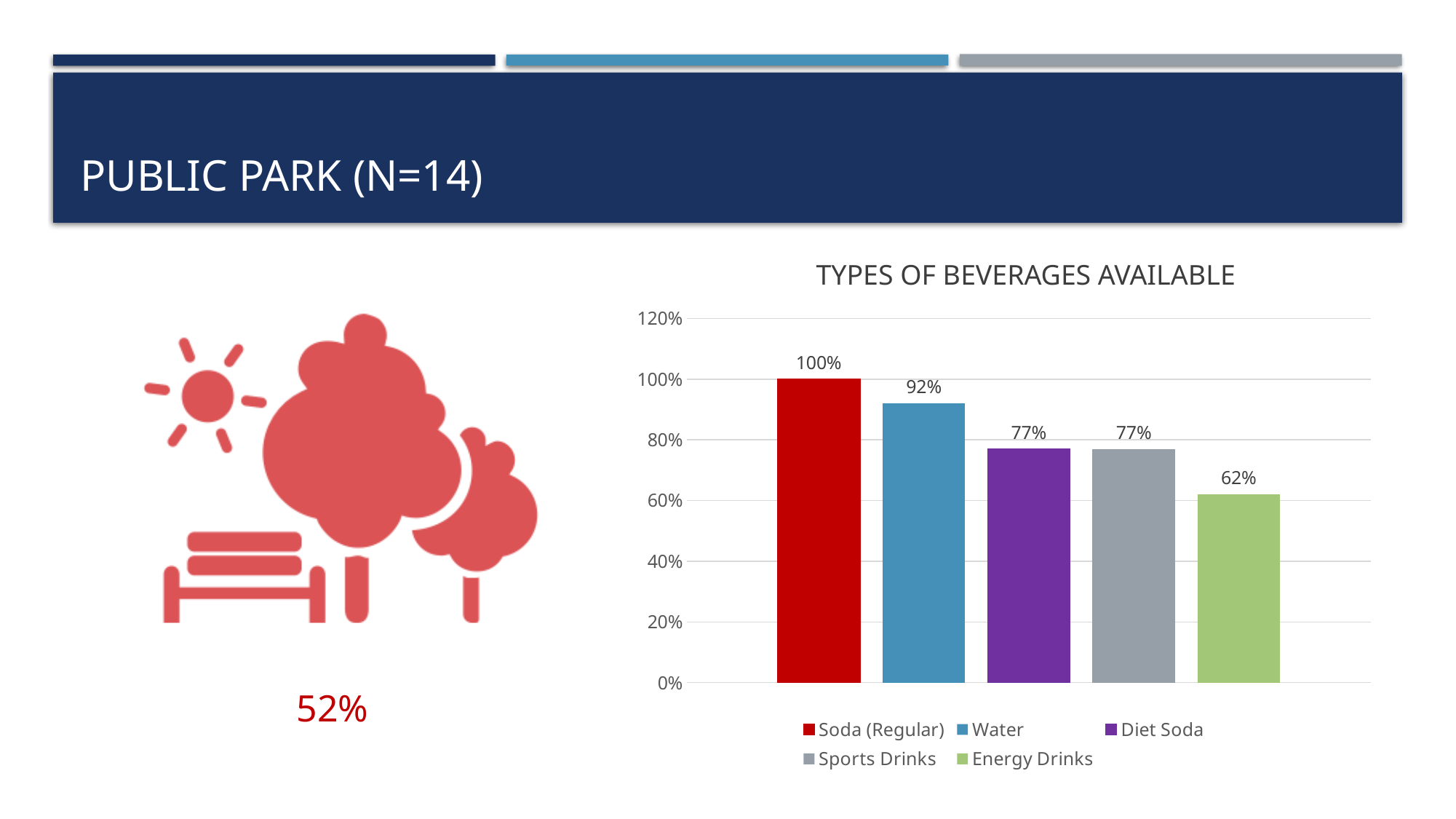
What is the title of the chart on the slide? Types of Beverages Available Which beverage type has the lowest value in the chart? Energy Drinks What is the value for Diet Soda in the Types of Beverages Available chart? 77% What kind of chart is used to show the types of beverages available? Bar chart What is the value for Soda (Regular) in the Types of Beverages Available chart? 100% What is the difference between the values for Soda (Regular) and Energy Drinks? 38% How many beverage types are shown in the chart? 5 What is the value for Energy Drinks in the Types of Beverages Available chart? 62% Which beverage type has the highest value in the chart? Soda (Regular) What is the value for Water in the Types of Beverages Available chart? 92% Which is larger, the value for Water or the value for Diet Soda? Water What is the difference between the values for Water and Sports Drinks? 15%